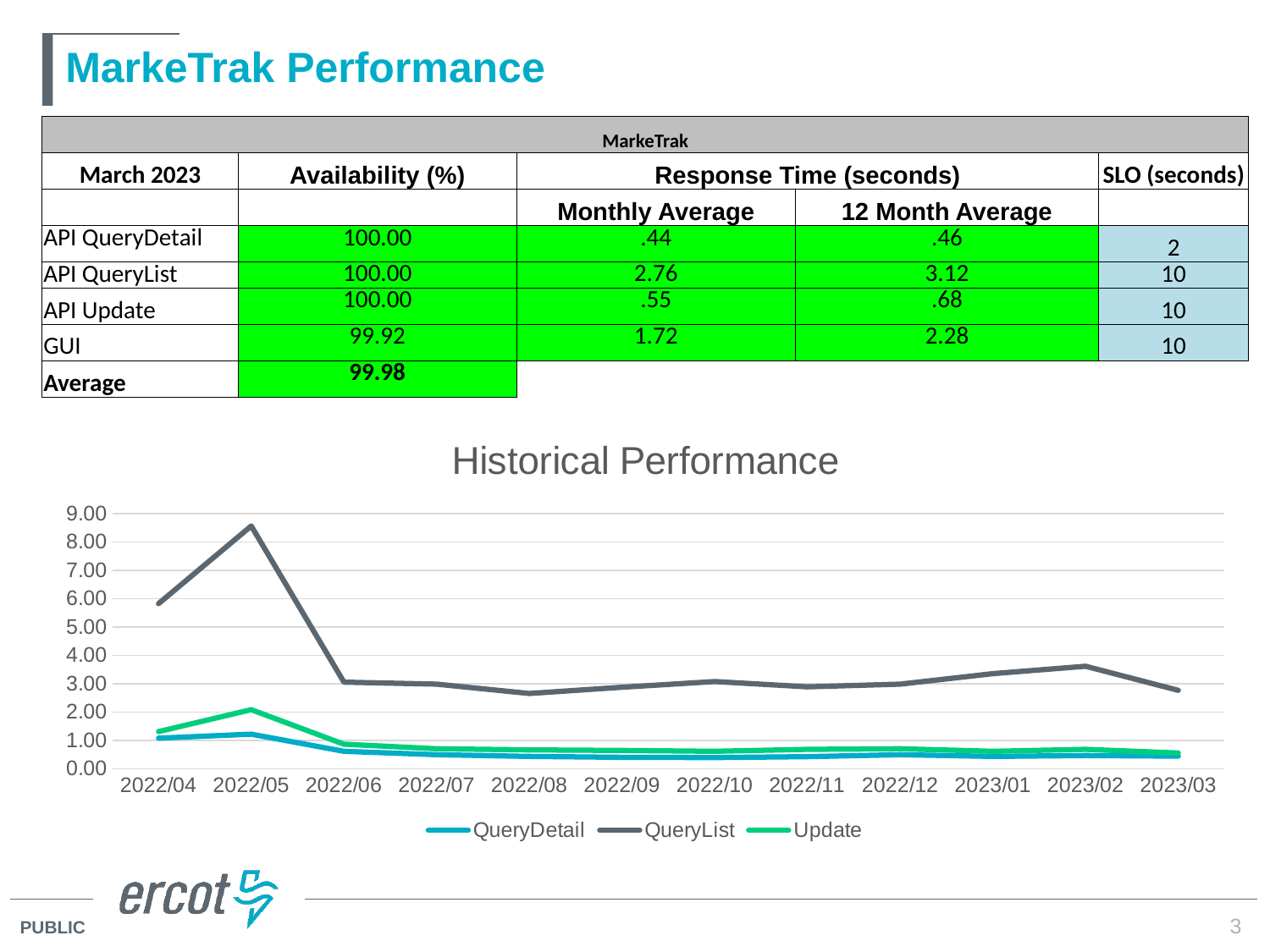
How many series does the legend of the Historical Performance chart list? 3 What is the title of the line chart on the slide? Historical Performance How many months are plotted along the x axis of the Historical Performance chart? 12 In the Historical Performance chart, is the QueryDetail value for 2023/03 greater or less than 1.00? less In the Historical Performance chart, which series has the highest values across the whole period? QueryList In the Historical Performance chart, is the QueryList value larger at 2022/05 or at 2023/02? 2022/05 In the Historical Performance chart, in which month does the QueryList series reach its highest value? 2022/05 In the Historical Performance chart, is the QueryList value for 2022/05 greater or less than 8.00? greater What kind of chart is the Historical Performance chart? line chart In the Historical Performance chart, is the QueryList value for 2022/04 greater or less than 5.00? greater In the Historical Performance chart, does the QueryList series rise or fall from 2022/05 to 2022/06? fall